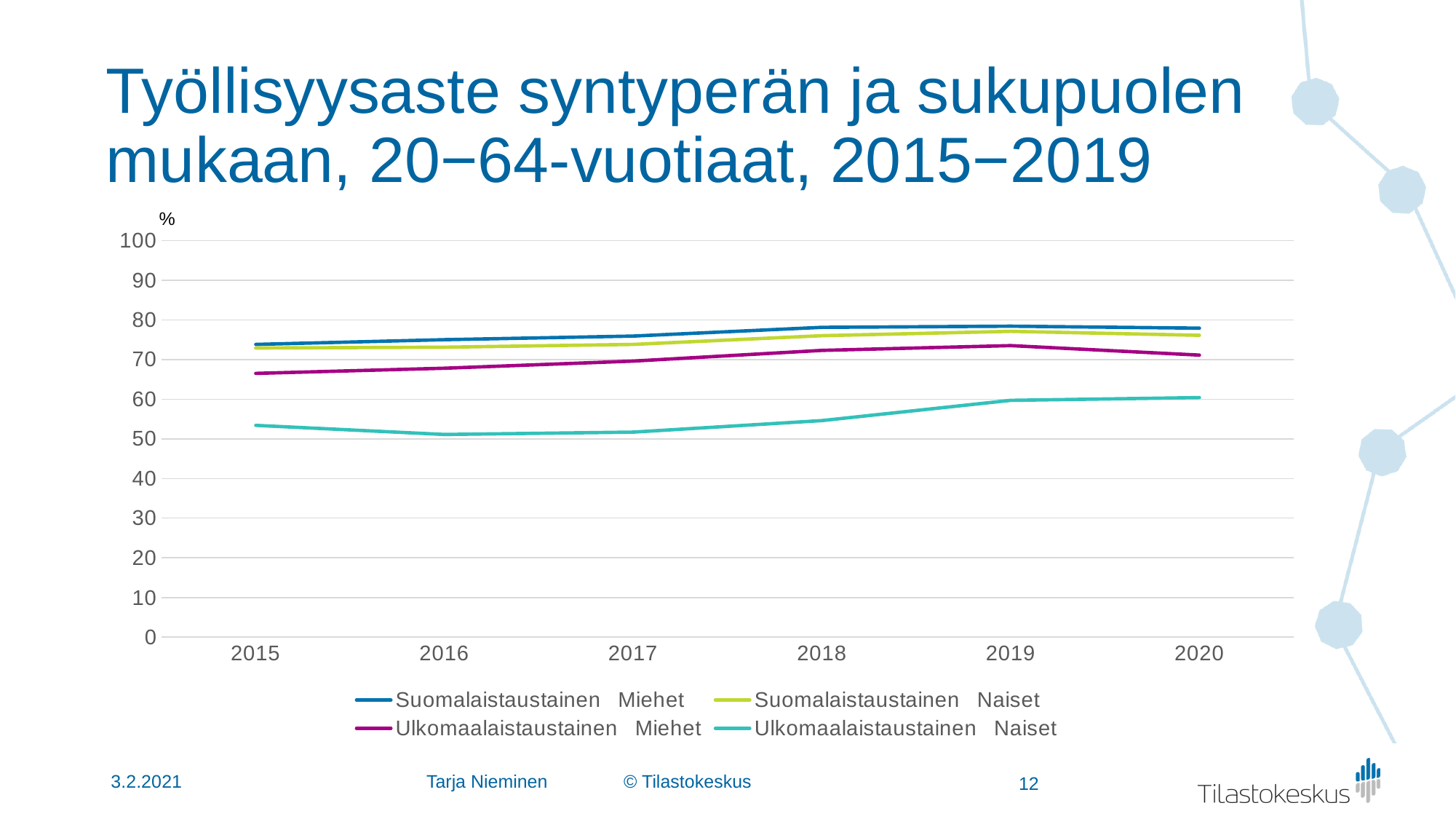
Which series has the highest value in 2020? Suomalaistaustainen Miehet In 2015, which is larger: Suomalaistaustainen Miehet or Ulkomaalaistaustainen Miehet? Suomalaistaustainen Miehet What kind of chart is shown on the slide? line chart What unit is shown at the top of the y axis? % Is the value for Ulkomaalaistaustainen Naiset in 2016 greater or less than 60? less Is the value for Ulkomaalaistaustainen Miehet in 2015 greater or less than 70? less How many years are shown on the x axis? 6 Is the value for Ulkomaalaistaustainen Naiset in 2019 greater or less than 50? greater How many series does the legend list? 4 Which series has the lowest value in 2015? Ulkomaalaistaustainen Naiset Does the Ulkomaalaistaustainen Naiset line rise or fall from 2016 to 2019? rise